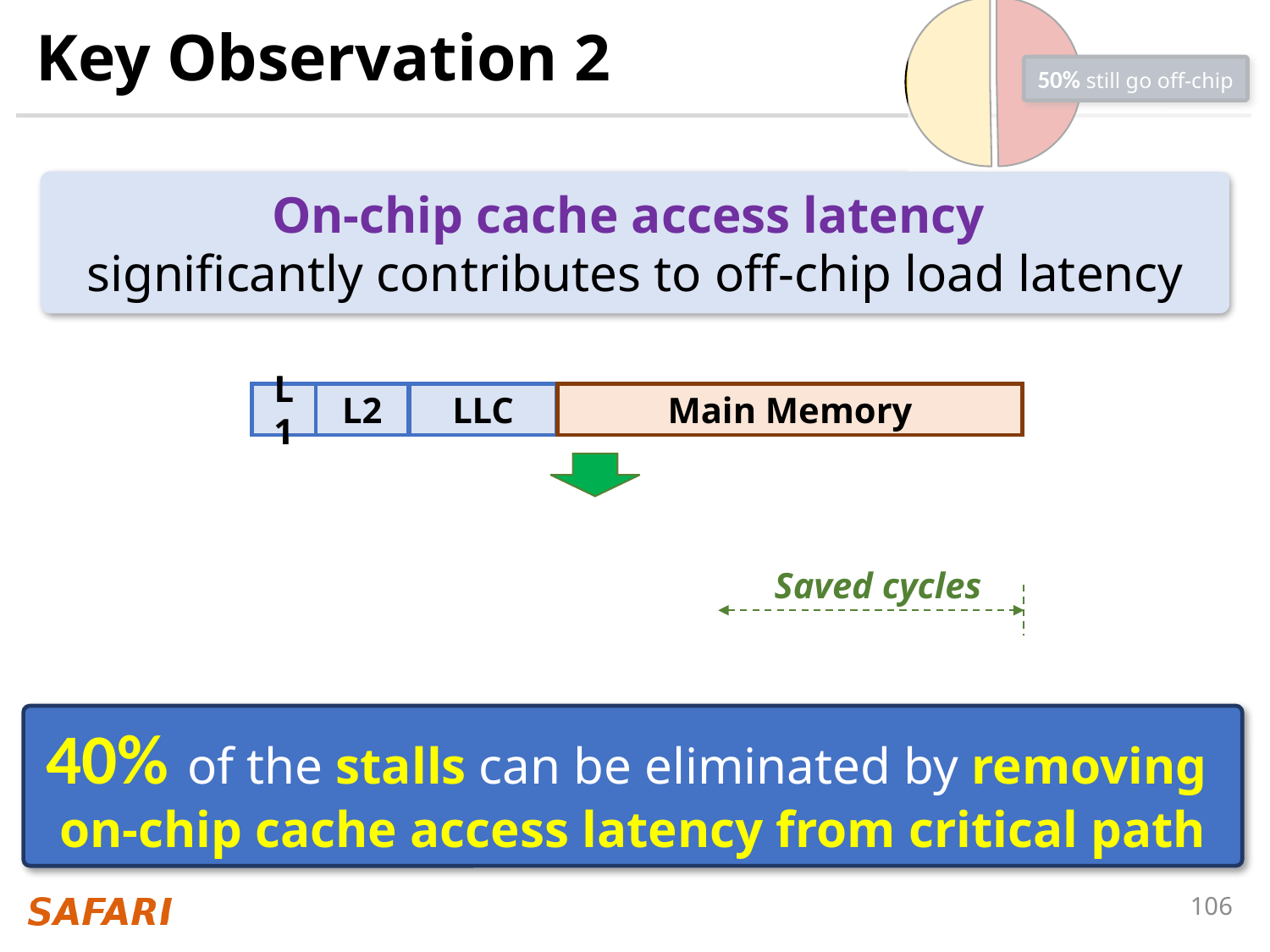
What does the label attached to the red slice of the pie chart in the top-right corner say? 50% still go off-chip In the pie chart in the top-right corner, what colour is the slice labelled "50% still go off-chip"? red In the pie chart in the top-right corner, what share of the pie is labelled as still going off-chip? 50% How many slices does the pie chart in the top-right corner have? 2 What kind of chart is shown in the top-right corner of the slide? pie chart